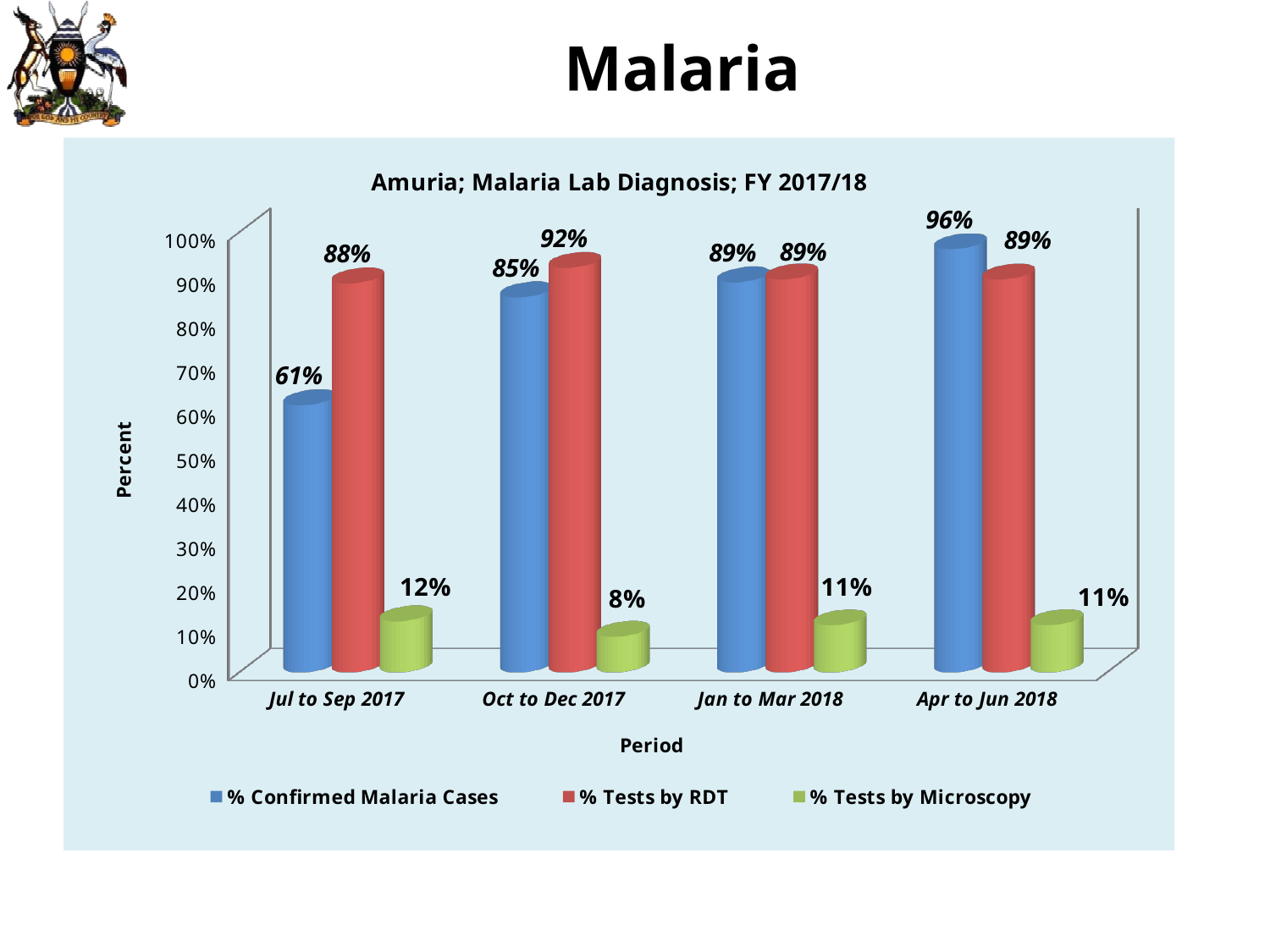
What kind of chart is shown? Bar chart Which period has the highest % Confirmed Malaria Cases? Apr to Jun 2018 What is the title of the chart? Amuria; Malaria Lab Diagnosis; FY 2017/18 What is the % Tests by Microscopy value for Apr to Jun 2018? 11% Which period has the lowest % Tests by Microscopy? Oct to Dec 2017 How many periods are shown on the x axis? 4 Does % Confirmed Malaria Cases rise or fall across the periods from Jul to Sep 2017 to Apr to Jun 2018? Rise What is the % Confirmed Malaria Cases value for Jul to Sep 2017? 61% How many series does the legend list? 3 What is the difference between % Confirmed Malaria Cases in Apr to Jun 2018 and Jul to Sep 2017? 35% What is the % Tests by RDT value for Oct to Dec 2017? 92% Which is larger for Jul to Sep 2017: % Confirmed Malaria Cases or % Tests by RDT? % Tests by RDT